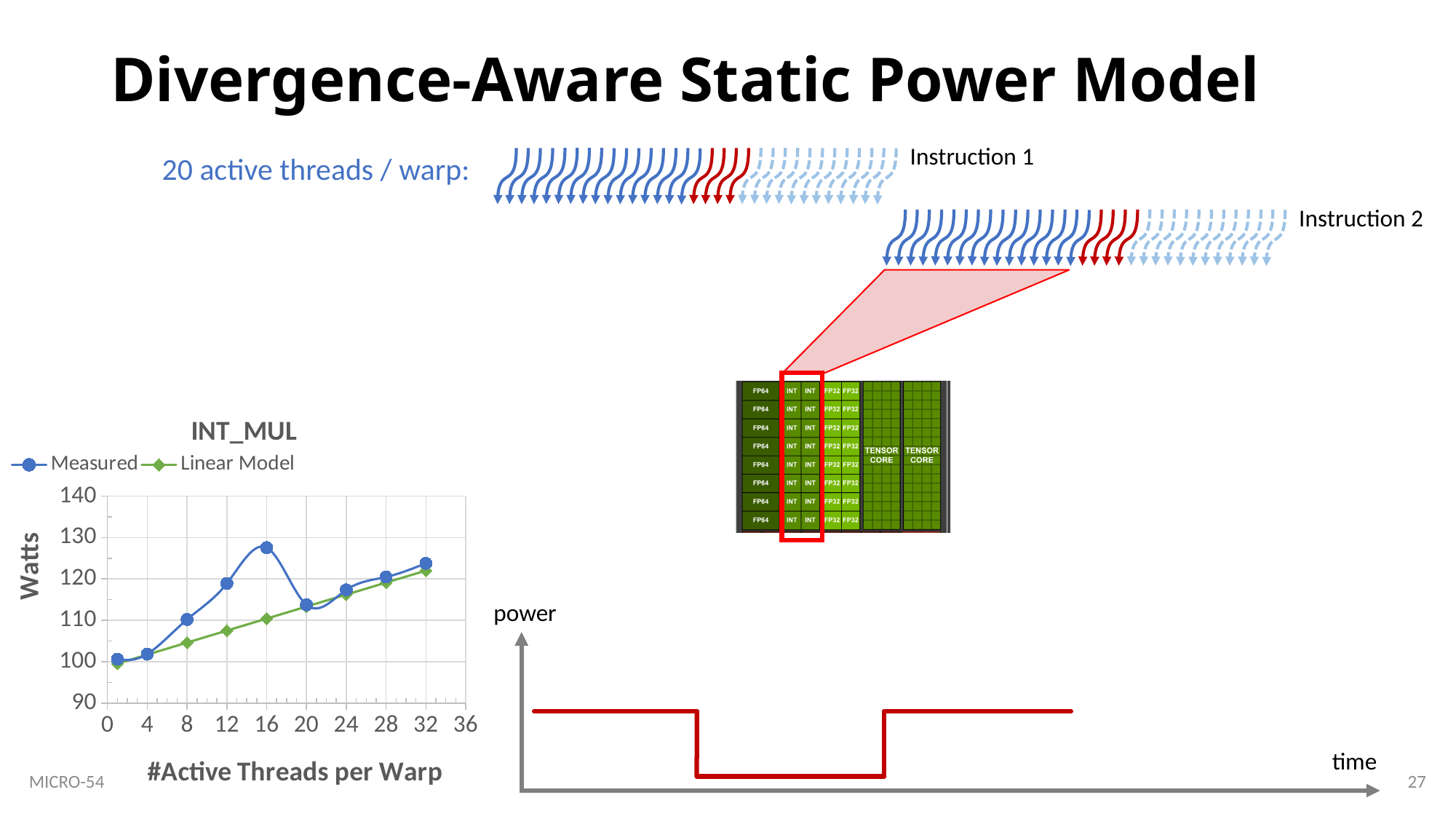
In the INT_MUL chart, at 16 active threads per warp, which series has the larger value, Measured or Linear Model? Measured In the INT_MUL chart, is the Measured value at 32 active threads per warp greater or less than 120? greater In the INT_MUL chart, is the Measured value at 4 active threads per warp greater or less than 110? less What is the title of the chart on the left of the slide? INT_MUL How many series does the legend of the INT_MUL chart list? 2 What kind of chart is the INT_MUL chart? line chart What is the y-axis label of the INT_MUL chart? Watts In the INT_MUL chart, is the Linear Model value at 16 active threads per warp greater or less than 120? less In the INT_MUL chart, at which number of active threads per warp does the Measured series reach its highest value? 16 In the INT_MUL chart, how many data points does the Measured series have? 9 In the INT_MUL chart, does the Linear Model series rise or fall as the number of active threads per warp increases? rises